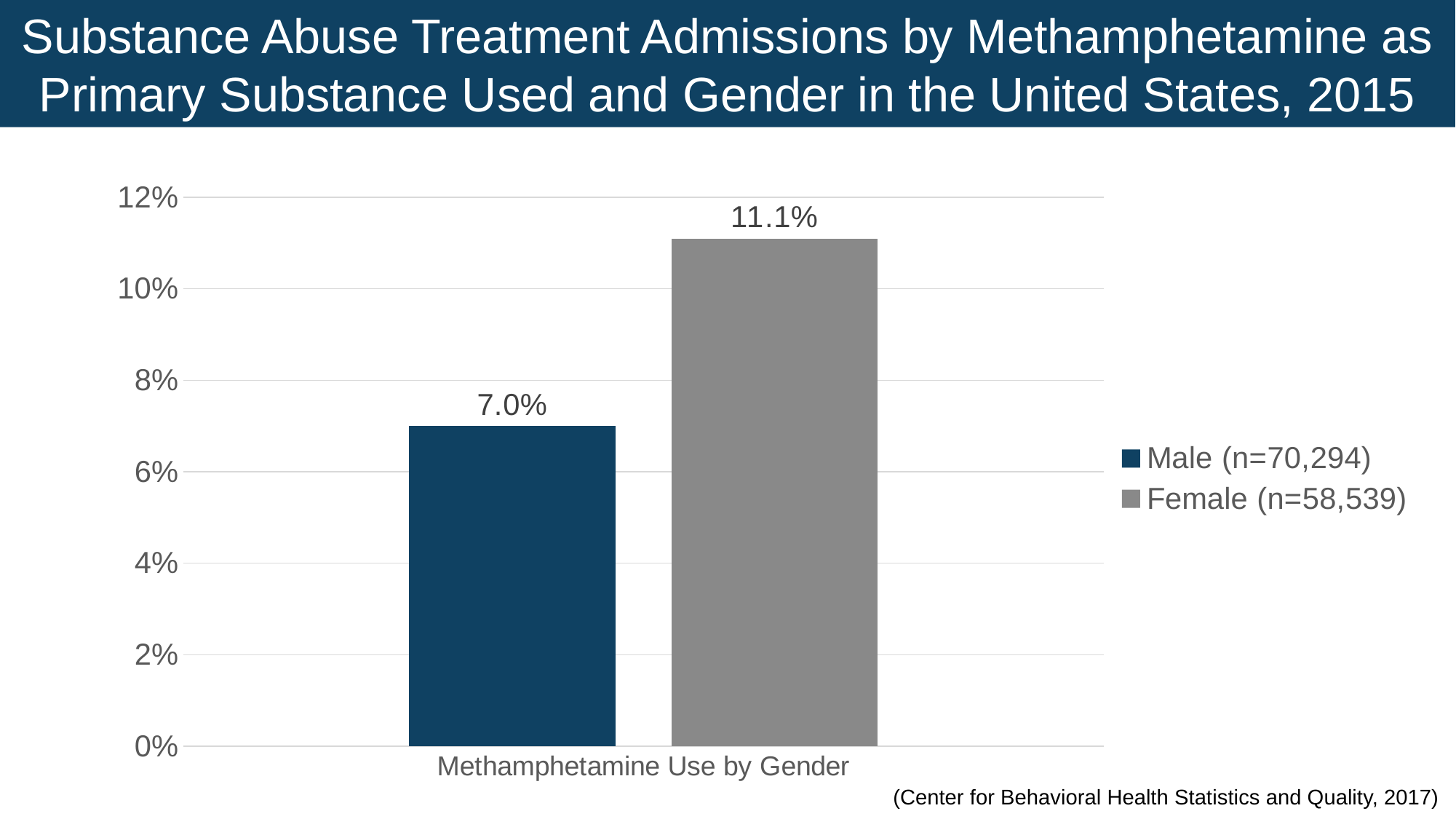
Is the value for females greater or less than 10%? greater What percentage of substance abuse treatment admissions had methamphetamine as the primary substance for females? 11.1% What percentage of substance abuse treatment admissions had methamphetamine as the primary substance for males? 7.0% What kind of chart is shown on the slide? Bar chart What is the difference in percentage points between the female and male values? 4.1 percentage points What is the label on the x axis of the chart? Methamphetamine Use by Gender Which gender has the higher percentage of methamphetamine as primary substance in treatment admissions? Female What is the sample size (n) for females shown in the legend? 58,539 What is the sample size (n) for males shown in the legend? 70,294 Is the value for males greater or less than 8%? less Which gender has the lower percentage of methamphetamine as primary substance in treatment admissions? Male How many series does the legend list? 2